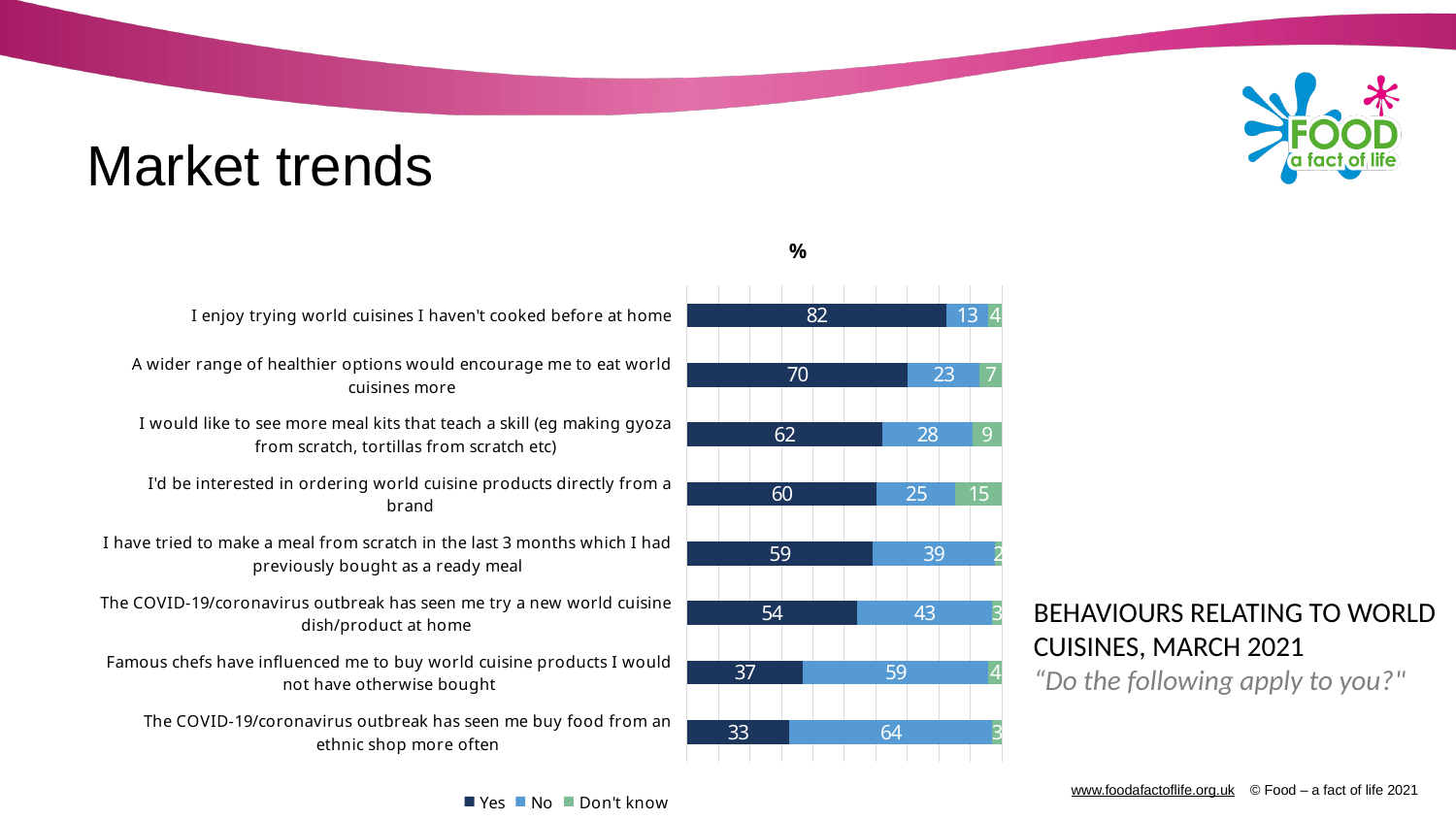
What is the difference between the "Yes" values for "A wider range of healthier options would encourage me to eat world cuisines more" and "I would like to see more meal kits that teach a skill"? 8 How many series does the legend list? 3 What is the "Don't know" value for "I'd be interested in ordering world cuisine products directly from a brand"? 15 What are the three legend entries of the chart? Yes, No, Don't know Which statement has the lowest "Yes" value? The COVID-19/coronavirus outbreak has seen me buy food from an ethnic shop more often What percentage answered "Yes" to "I enjoy trying world cuisines I haven't cooked before at home"? 82 What kind of chart is shown on the slide? Stacked bar chart How many statements (categories) are shown in the chart? 8 What is the total of the stacked bar for "I would like to see more meal kits that teach a skill"? 99 Which is larger: the "No" value for "I have tried to make a meal from scratch in the last 3 months" or the "No" value for "The COVID-19/coronavirus outbreak has seen me try a new world cuisine dish/product at home"? The COVID-19/coronavirus outbreak has seen me try a new world cuisine dish/product at home What is the "No" value for "Famous chefs have influenced me to buy world cuisine products I would not have otherwise bought"? 59 Which statement has the highest "Yes" value? I enjoy trying world cuisines I haven't cooked before at home